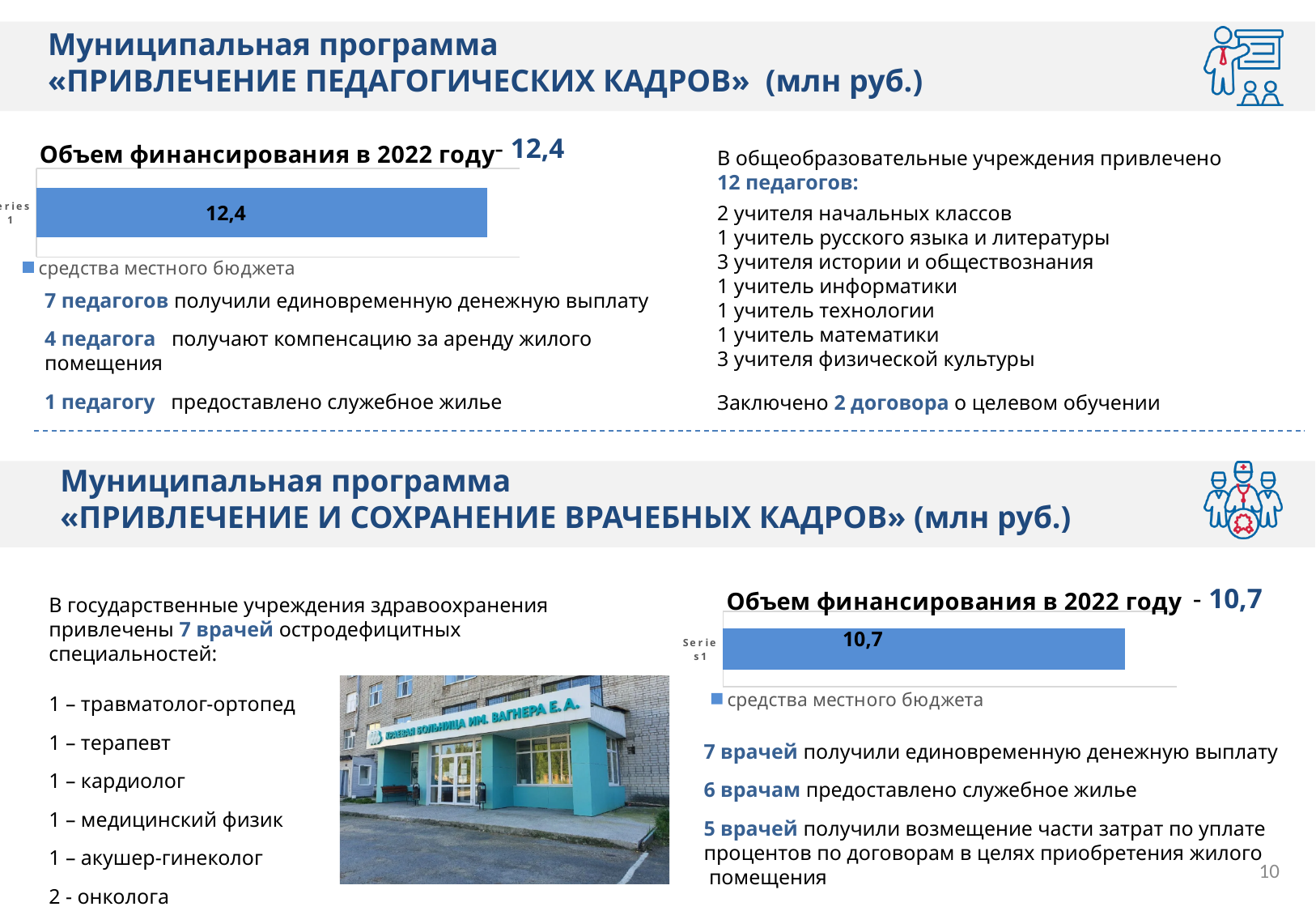
What is the title of the bottom chart? Объем финансирования в 2022 году What is the difference between the value on the top chart (12,4) and the value on the bottom chart (10,7)? 1,7 On the bottom chart (medical staff program), what value is shown for the bar labelled Series 1? 10,7 Which is larger: the funding value on the top chart (12,4) or the funding value on the bottom chart (10,7)? top chart (12,4) How many bars are plotted on the bottom chart? 1 What kind of chart is the top chart on the slide? bar chart What kind of chart is the bottom chart on the slide? bar chart How many bars are plotted on the top chart? 1 What legend entry is shown under the top chart? средства местного бюджета On the top chart (teacher recruitment program), what value is shown for the bar labelled Series 1? 12,4 How many series does the legend of the top chart list? 1 How many series does the legend of the bottom chart list? 1